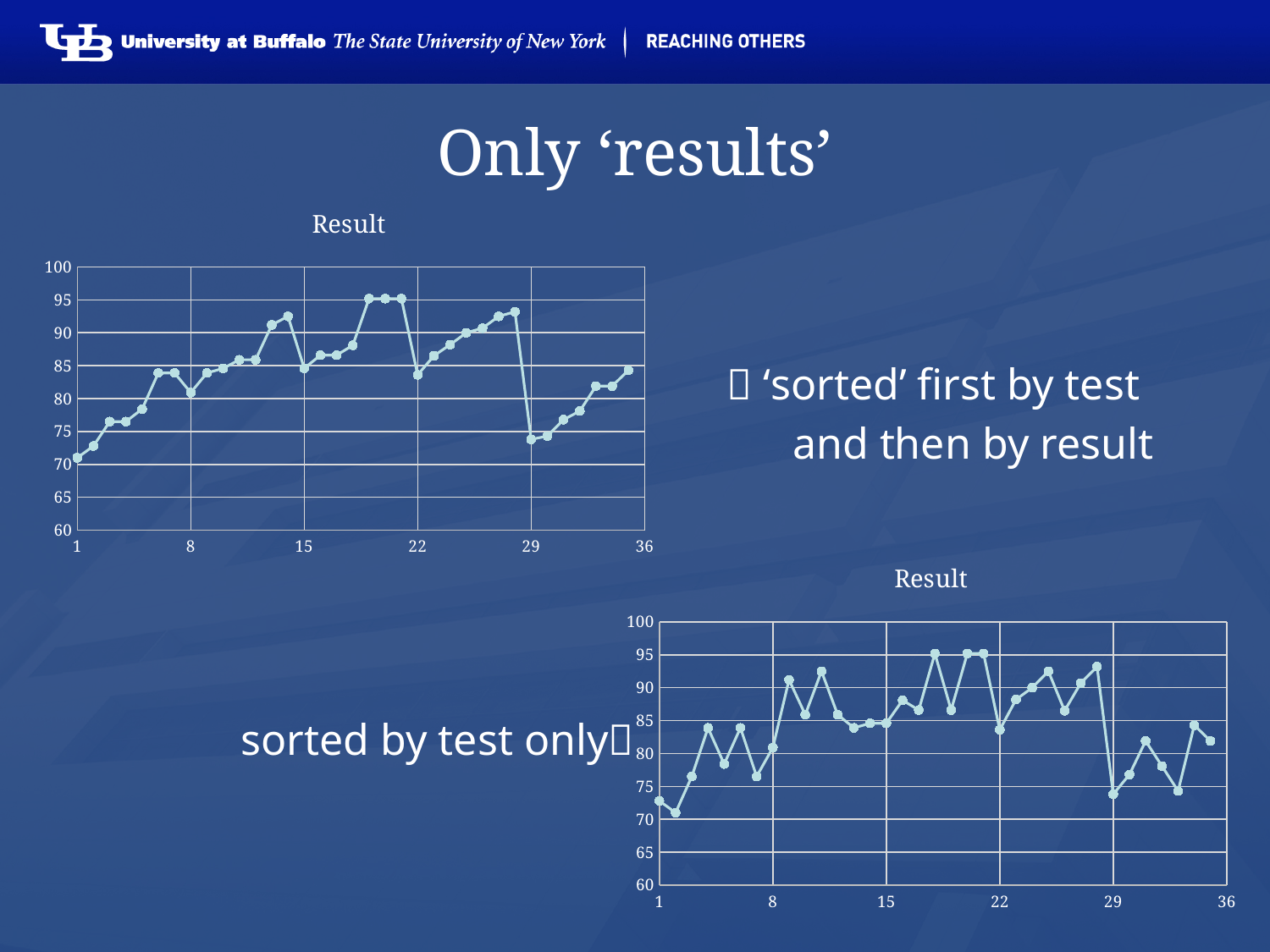
In the top-left chart, is the value at x = 22 greater or less than 90? less What is the title of the top-left chart? Result In the top-left chart, do the values rise or fall from x = 1 to x = 7? rise What kind of chart is the top-left chart on the slide? line chart In the top-left chart, which is larger: the value at x = 22 or the value at x = 29? x = 22 In the top-left chart, is the value at x = 8 greater or less than 75? greater In the bottom-right chart, is the value at x = 22 greater or less than 90? less What kind of chart is the bottom-right chart on the slide? line chart In the bottom-right chart, which is larger: the value at x = 15 or the value at x = 29? x = 15